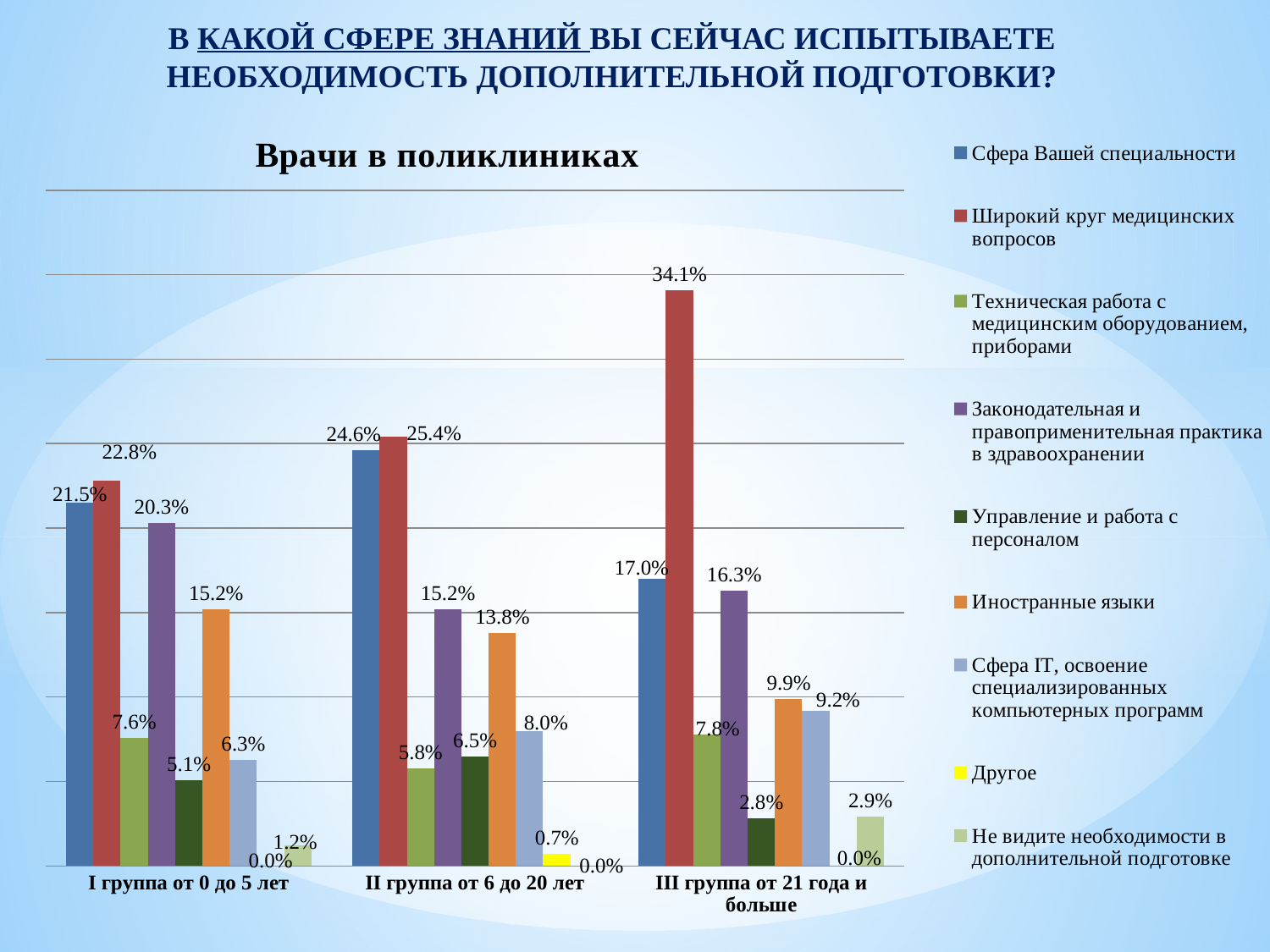
Does the value for Широкий круг медицинских вопросов rise or fall from I группа to III группа? Rises What kind of chart is shown on the slide? Bar chart Which series has the lowest value in I группа от 0 до 5 лет? Другое What is the value for Широкий круг медицинских вопросов in III группа от 21 года и больше? 34.1% What is the value for Иностранные языки in I группа от 0 до 5 лет? 15.2% What is the difference between the values for Сфера Вашей специальности in II группа от 6 до 20 лет and III группа от 21 года и больше? 7.6 percentage points What is the value for Сфера IT, освоение специализированных компьютерных программ in III группа от 21 года и больше? 9.2% What is the value for Другое in II группа от 6 до 20 лет? 0.7% How many series does the legend list? 9 In which group is the value for Широкий круг медицинских вопросов the highest? III группа от 21 года и больше Which group has the larger value for Законодательная и правоприменительная практика в здравоохранении: I группа от 0 до 5 лет or II группа от 6 до 20 лет? I группа от 0 до 5 лет How many groups are shown on the x axis? 3